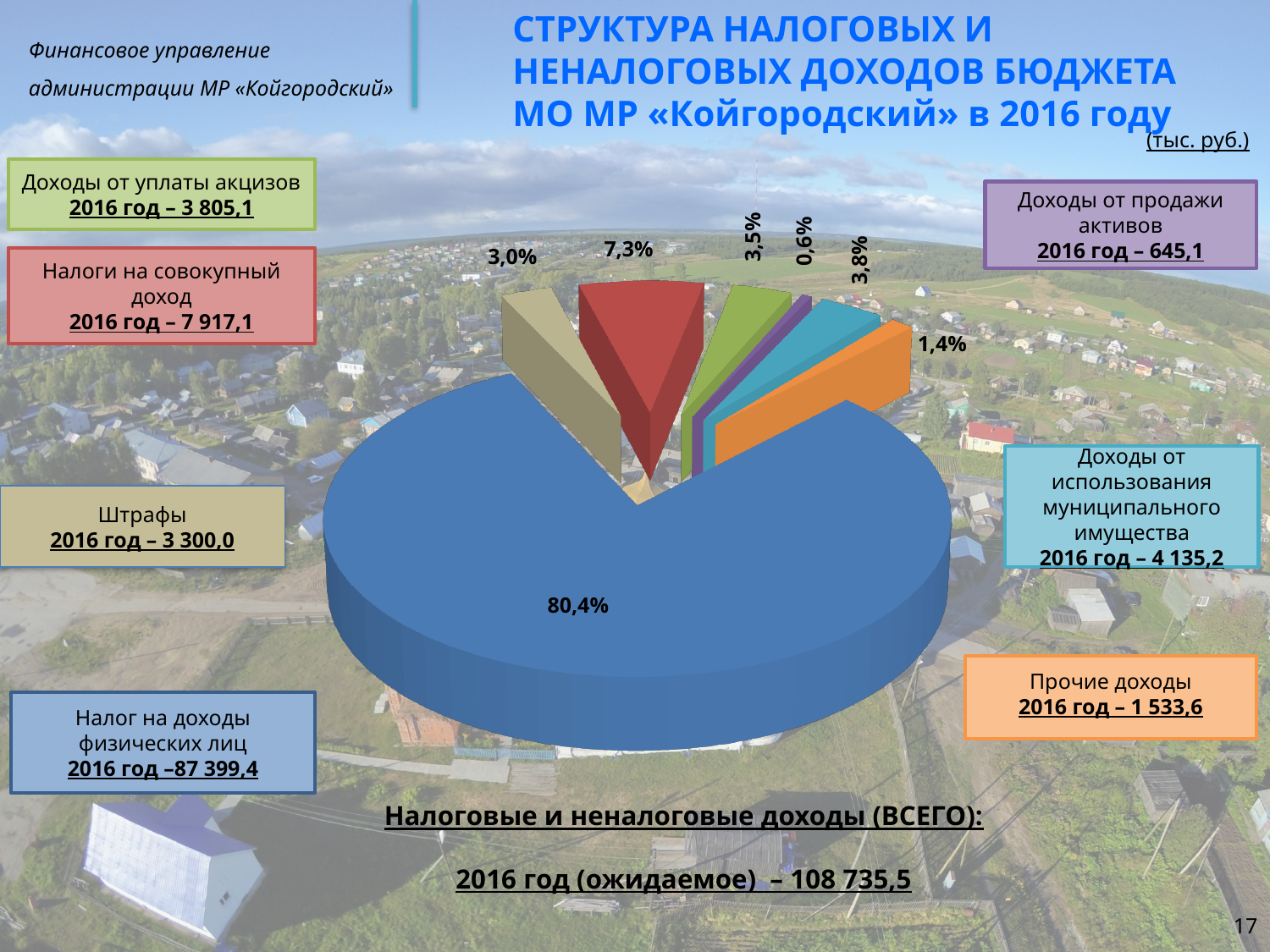
What is the 2016 value for Штрафы shown in the label box? 3 300,0 What total for Налоговые и неналоговые доходы (ВСЕГО) in 2016 is stated below the chart? 108 735,5 What is the 2016 value for Доходы от продажи активов shown in the label box? 645,1 What is the largest percentage shown on the pie chart? 80,4% What is the 2016 value for Налог на доходы физических лиц shown in the label box? 87 399,4 How many slices does the pie chart have? 7 What kind of chart is shown on the slide? Pie chart Which is larger: the 7,3% slice or the 3,8% slice? 7,3% What share of the pie does the red slice (Налоги на совокупный доход) represent? 7,3% What is the smallest percentage shown on the pie chart? 0,6% What share of the pie does the blue slice (Налог на доходы физических лиц) represent? 80,4% What is the difference in percentage points between the 3,8% slice and the 1,4% slice? 2,4